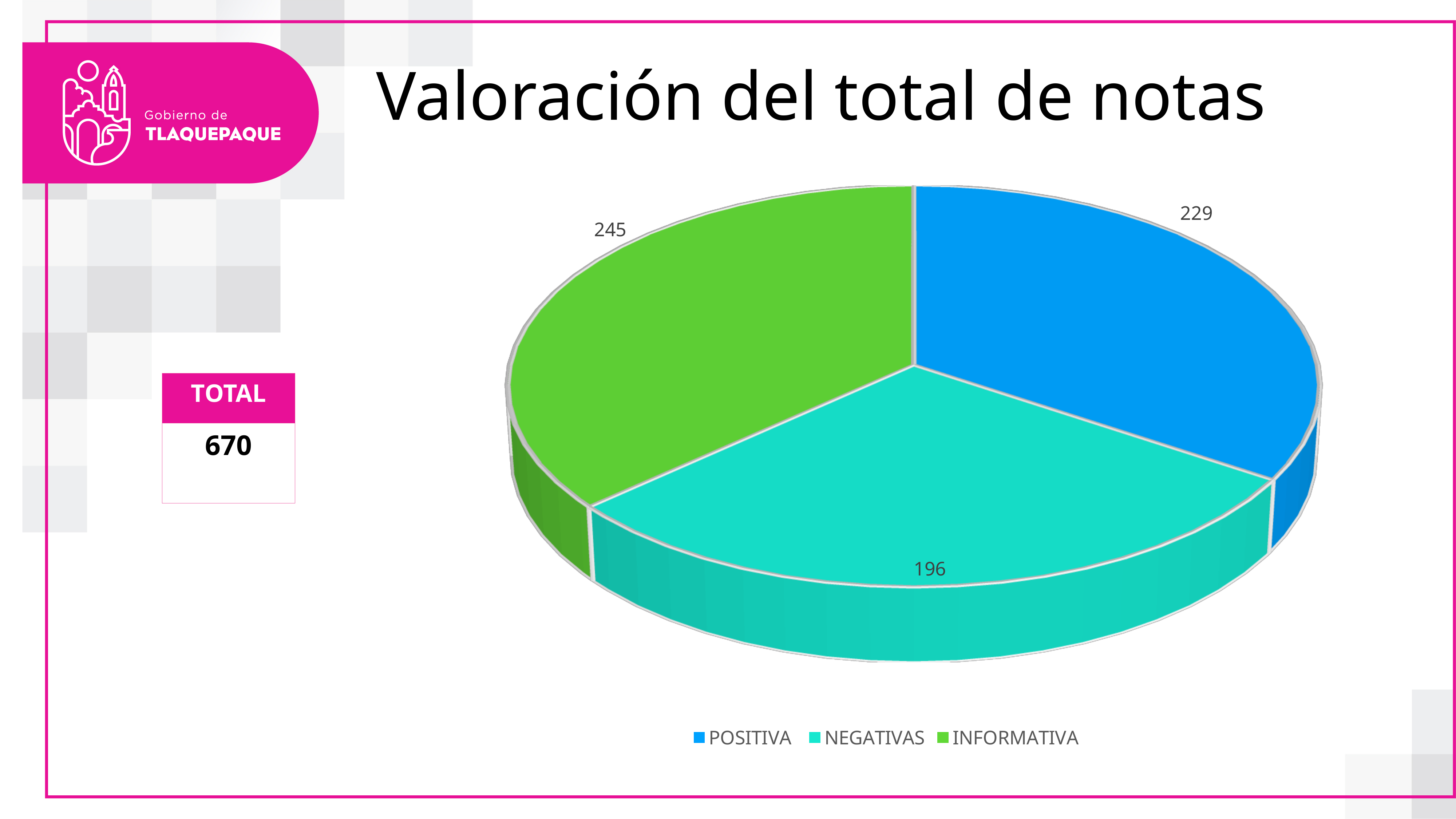
Which category has the largest slice? INFORMATIVA Which is larger, POSITIVA or NEGATIVAS? POSITIVA What is the value of the POSITIVA slice? 229 What is the difference between the POSITIVA and NEGATIVAS values? 33 Which category has the smallest slice? NEGATIVAS What is the total of all three slices? 670 What is the value of the INFORMATIVA slice? 245 What is the difference between the INFORMATIVA and NEGATIVAS values? 49 What is the value of the NEGATIVAS slice? 196 What is the title of the chart? Valoración del total de notas How many slices does the pie chart have? 3 What kind of chart is shown on the slide? Pie chart